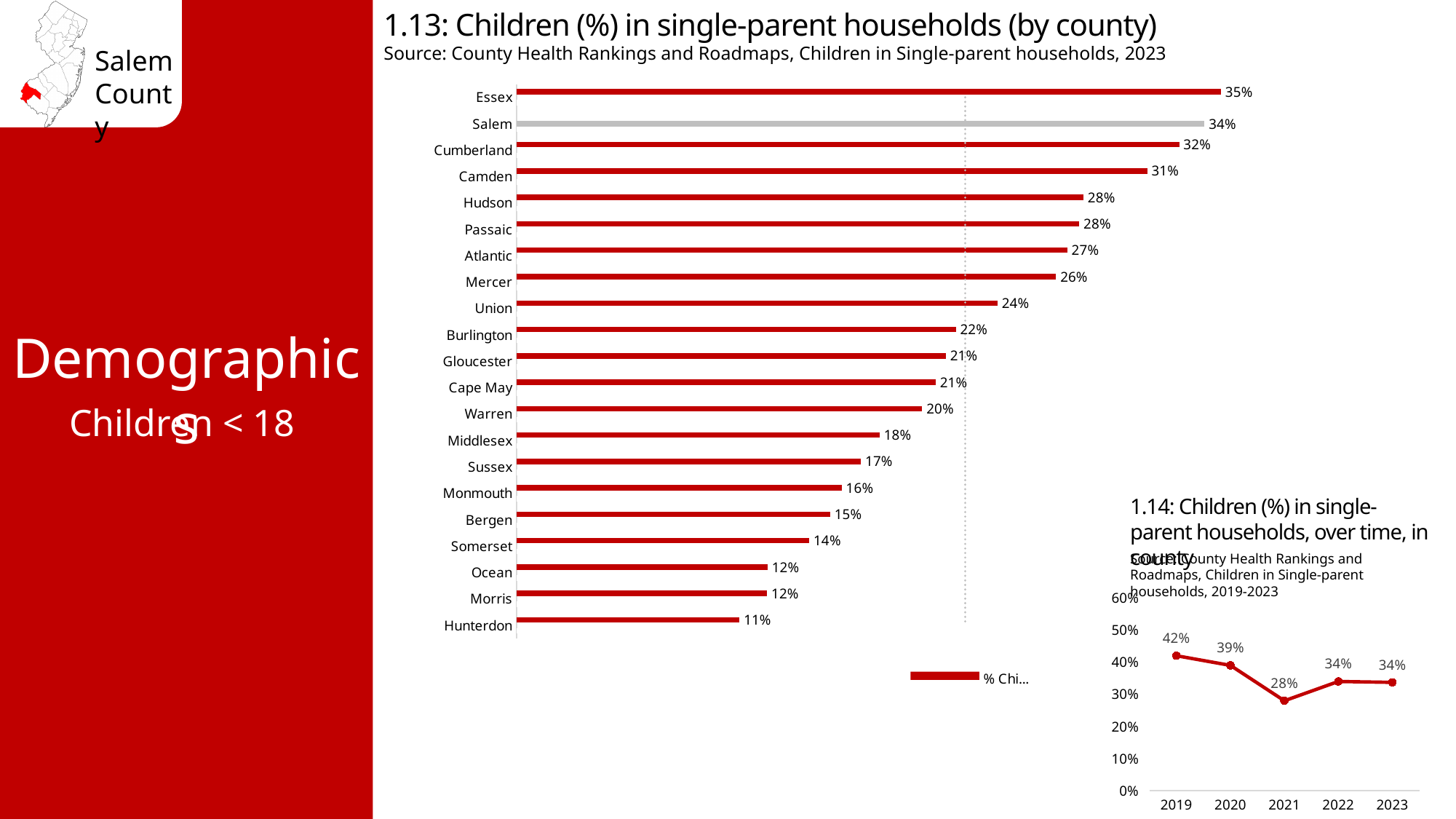
In chart 1.14 (over time, in county), what is the value for 2021? 28% In chart 1.13 (by county), which county has the lowest percentage of children in single-parent households? Hunterdon In chart 1.14 (over time, in county), what is the difference between the values for 2019 and 2021? 14% In chart 1.13 (by county), what is the value for Cumberland? 32% In chart 1.13 (by county), which has a higher value, Camden or Union? Camden In chart 1.13 (by county), what kind of chart is used? Bar chart In chart 1.13 (by county), what is the difference between the values for Essex and Hunterdon? 24% In chart 1.13 (by county), how many counties are shown? 21 In chart 1.14 (over time, in county), how many years are plotted? 5 In chart 1.13 (Children in single-parent households by county), what is the value for Salem? 34% In chart 1.14 (over time, in county), which year has the highest value? 2019 In chart 1.13 (by county), which county has the highest percentage of children in single-parent households? Essex